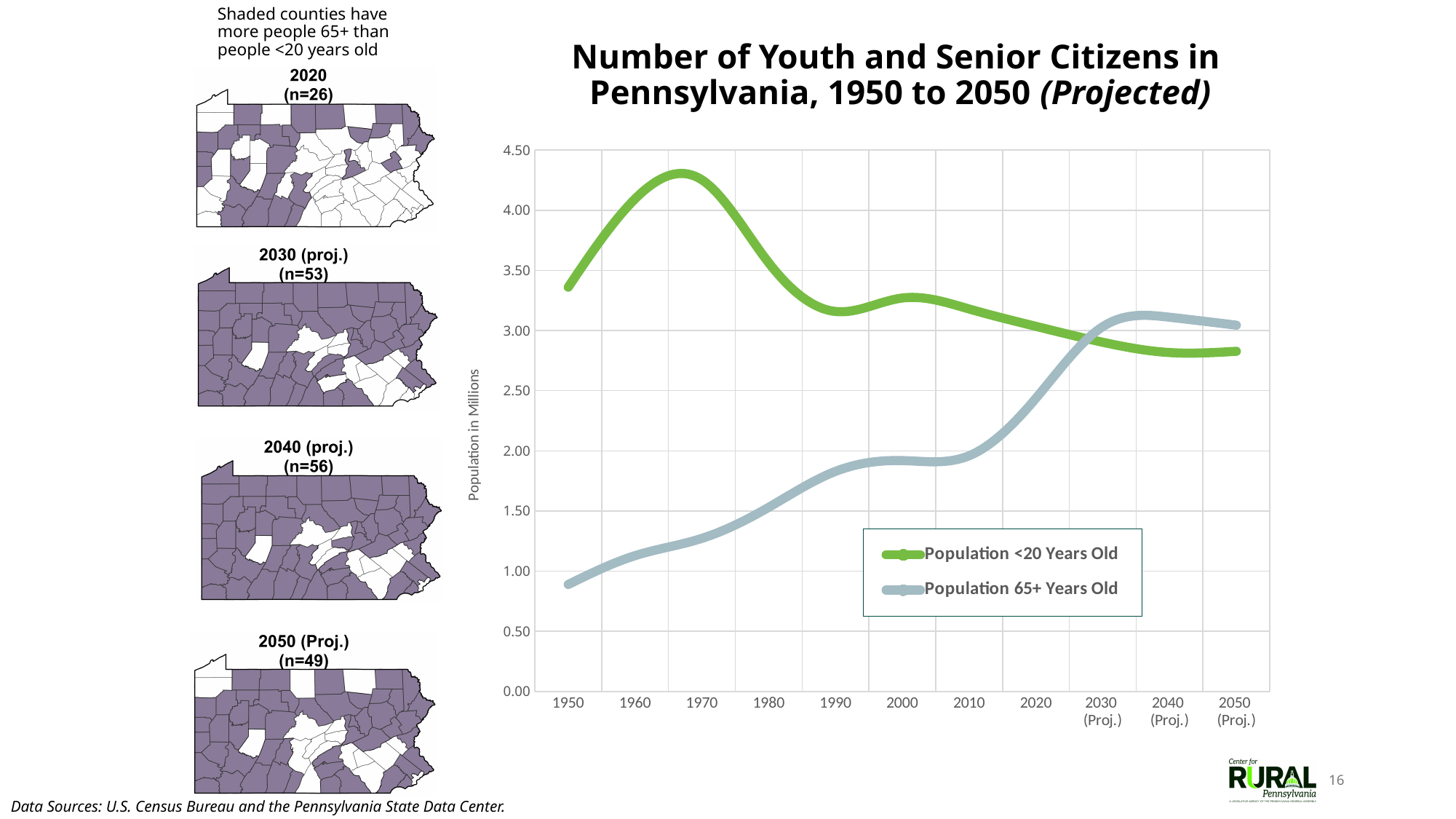
What is the label on the y axis of the line chart? Population in Millions In the line chart, is the value for Population 65+ Years Old in 2020 greater or less than 2.00? greater In the line chart, is the value for Population <20 Years Old in 1970 greater or less than 4.00? greater How many years are marked along the x axis of the line chart? 11 In the line chart, in which year does the Population <20 Years Old series reach its highest value? 1970 In the line chart, is the value for Population 65+ Years Old in 1950 greater or less than 1.00? less In the line chart, which series has the larger value in 2050 (Proj.)? Population 65+ Years Old In the line chart, does the Population 65+ Years Old series generally rise or fall from 1950 to 2050? rise What kind of chart is shown on the right side of the slide? line chart In the line chart, which series has the larger value in 1950? Population <20 Years Old How many series does the legend of the line chart list? 2